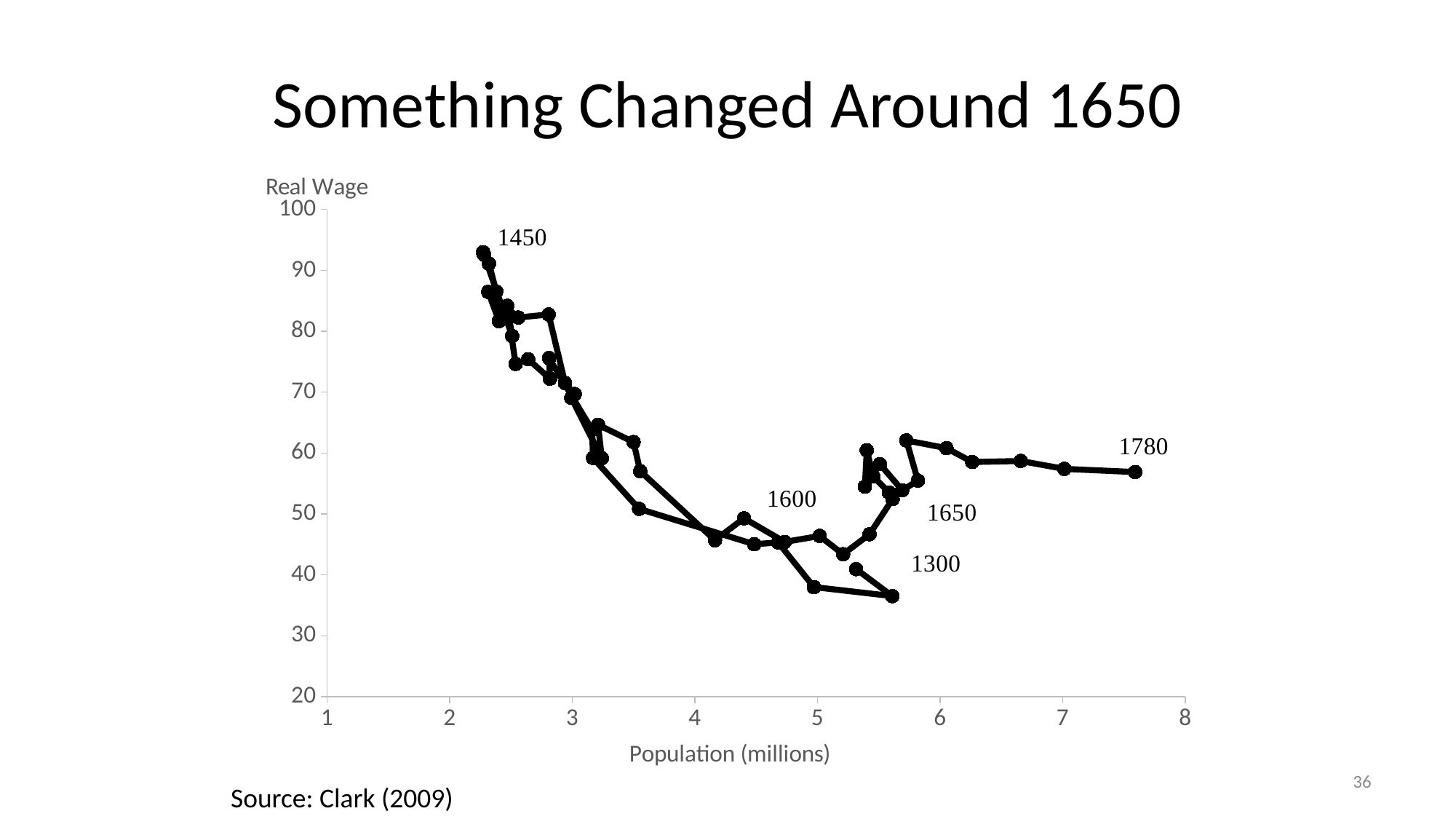
Which labelled year has the highest real wage on the chart? 1450 What is the label of the horizontal axis? Population (millions) Which has the higher real wage, the point labelled 1780 or the point labelled 1300? 1780 What kind of chart is shown on the slide? Scatter chart with connected points (line chart) What is the title of the slide's chart? Something Changed Around 1650 Which has the larger population, the point labelled 1450 or the point labelled 1650? 1650 Which labelled year has the lowest real wage on the chart? 1300 Which labelled year has the largest population on the chart? 1780 Is the population at the point labelled 1780 greater or less than 7 million? greater Is the real wage at the point labelled 1450 greater or less than 80? greater Is the real wage at the point labelled 1600 greater or less than 60? less